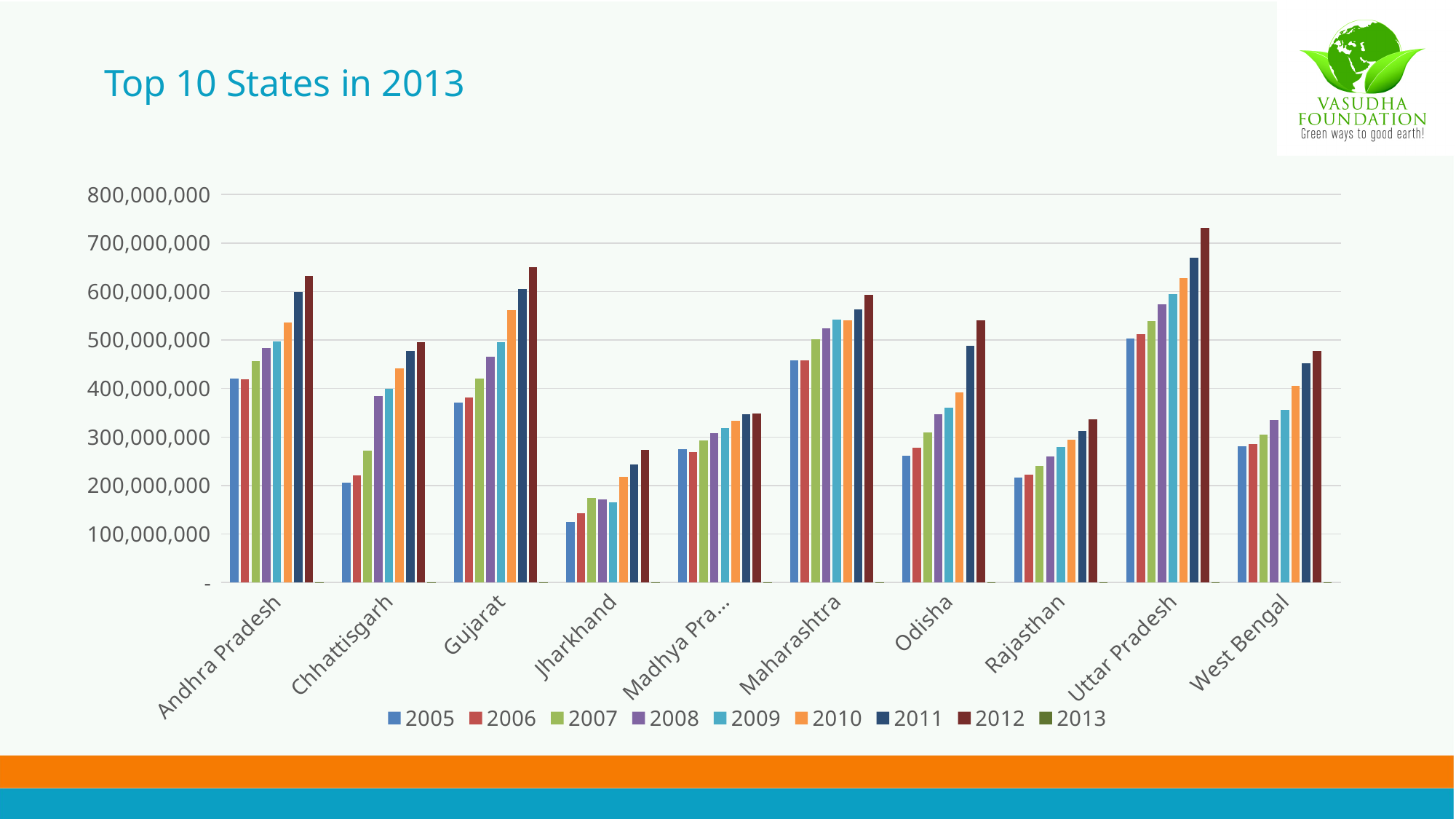
How many states are shown on the x axis of the chart? 10 Is the value for Uttar Pradesh in 2012 greater or less than 700,000,000? greater Which state has the highest value for 2005? Uttar Pradesh Is the value for Jharkhand in 2005 greater or less than 200,000,000? less What kind of chart is shown on the slide? Bar chart How many series does the chart's legend list? 9 What is the title of the chart on the slide? Top 10 States in 2013 Which state has the lowest value for 2012? Jharkhand Which is larger: the 2012 value for Uttar Pradesh or the 2012 value for Gujarat? Uttar Pradesh Which state has the highest value for 2012? Uttar Pradesh Is the value for Odisha in 2012 greater or less than 500,000,000? greater For Uttar Pradesh, do the values rise or fall from 2005 to 2012? Rise